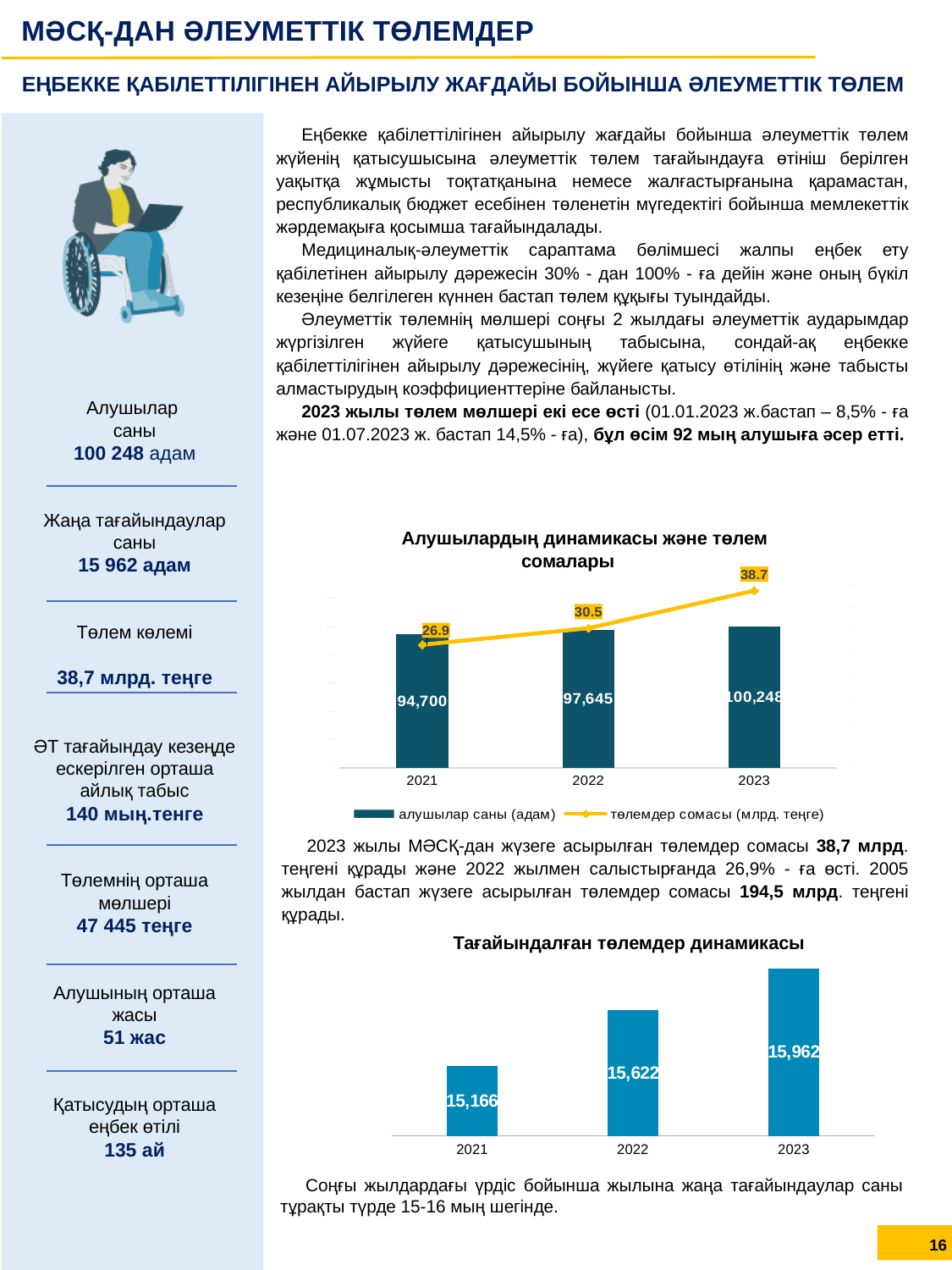
In the chart 'Алушылардың динамикасы және төлем сомалары', which year has the highest 'төлемдер сомасы (млрд. теңге)'? 2023 In the chart 'Тағайындалған төлемдер динамикасы', what is the difference between the values for 2023 and 2021? 796 What kind of chart is 'Тағайындалған төлемдер динамикасы'? bar chart In the chart 'Алушылардың динамикасы және төлем сомалары', does 'алушылар саны (адам)' rise or fall from 2021 to 2023? rise In the chart 'Алушылардың динамикасы және төлем сомалары', what is the value of 'төлемдер сомасы (млрд. теңге)' for 2021? 26.9 How many years are shown on the x axis of the chart 'Тағайындалған төлемдер динамикасы'? 3 In the chart 'Алушылардың динамикасы және төлем сомалары', what is the difference in 'төлемдер сомасы (млрд. теңге)' between 2023 and 2022? 8.2 How many series does the legend of the chart 'Алушылардың динамикасы және төлем сомалары' list? 2 In the chart 'Алушылардың динамикасы және төлем сомалары', what is the value of 'алушылар саны (адам)' for 2023? 100,248 In the chart 'Тағайындалған төлемдер динамикасы', which year has the highest value? 2023 In the chart 'Тағайындалған төлемдер динамикасы', what is the value for 2022? 15,622 In the chart 'Алушылардың динамикасы және төлем сомалары', which year has the lowest 'алушылар саны (адам)'? 2021